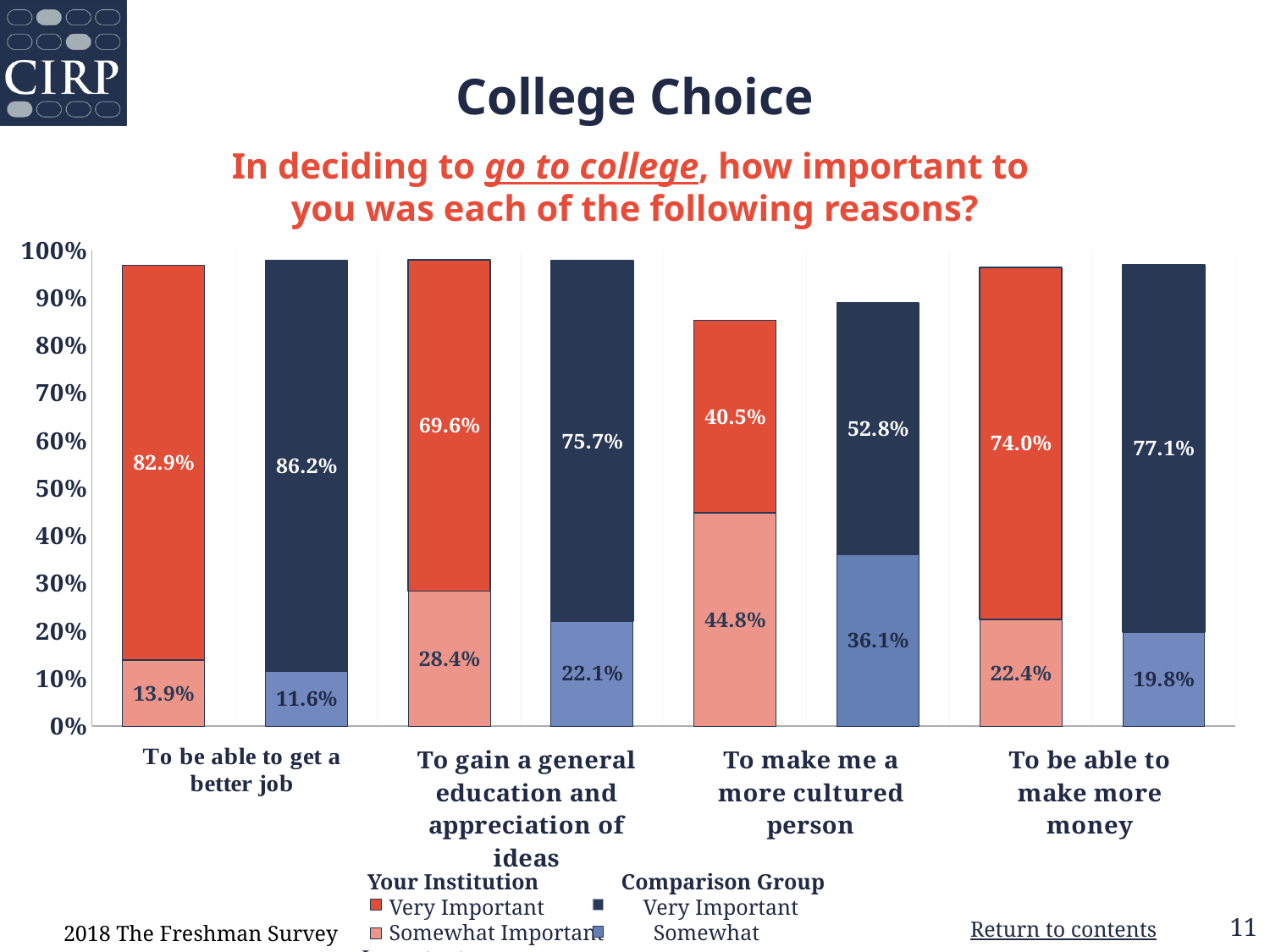
What is the combined total (Very Important plus Somewhat Important) of the Your Institution bar for "To be able to get a better job"? 96.8% How many series does the chart legend list? 4 How many reasons (categories) are shown on the x axis of the chart? 4 What type of chart is shown on the slide? Stacked bar chart What percentage of the Comparison Group rated "To make me a more cultured person" as Somewhat Important? 36.1% Among the Your Institution bars, which reason has the lowest Very Important percentage? To make me a more cultured person What is the combined total of the Comparison Group bar for "To make me a more cultured person"? 88.9% What percentage of Your Institution respondents rated "To be able to get a better job" as Very Important? 82.9% What is the difference between the Comparison Group and Your Institution Very Important percentages for "To make me a more cultured person"? 12.3% For "To gain a general education and appreciation of ideas", which is larger: the Your Institution Somewhat Important value or the Comparison Group Somewhat Important value? Your Institution Among the Comparison Group bars, which reason has the highest Very Important percentage? To be able to get a better job What is the Very Important percentage for the Comparison Group for "To be able to make more money"? 77.1%